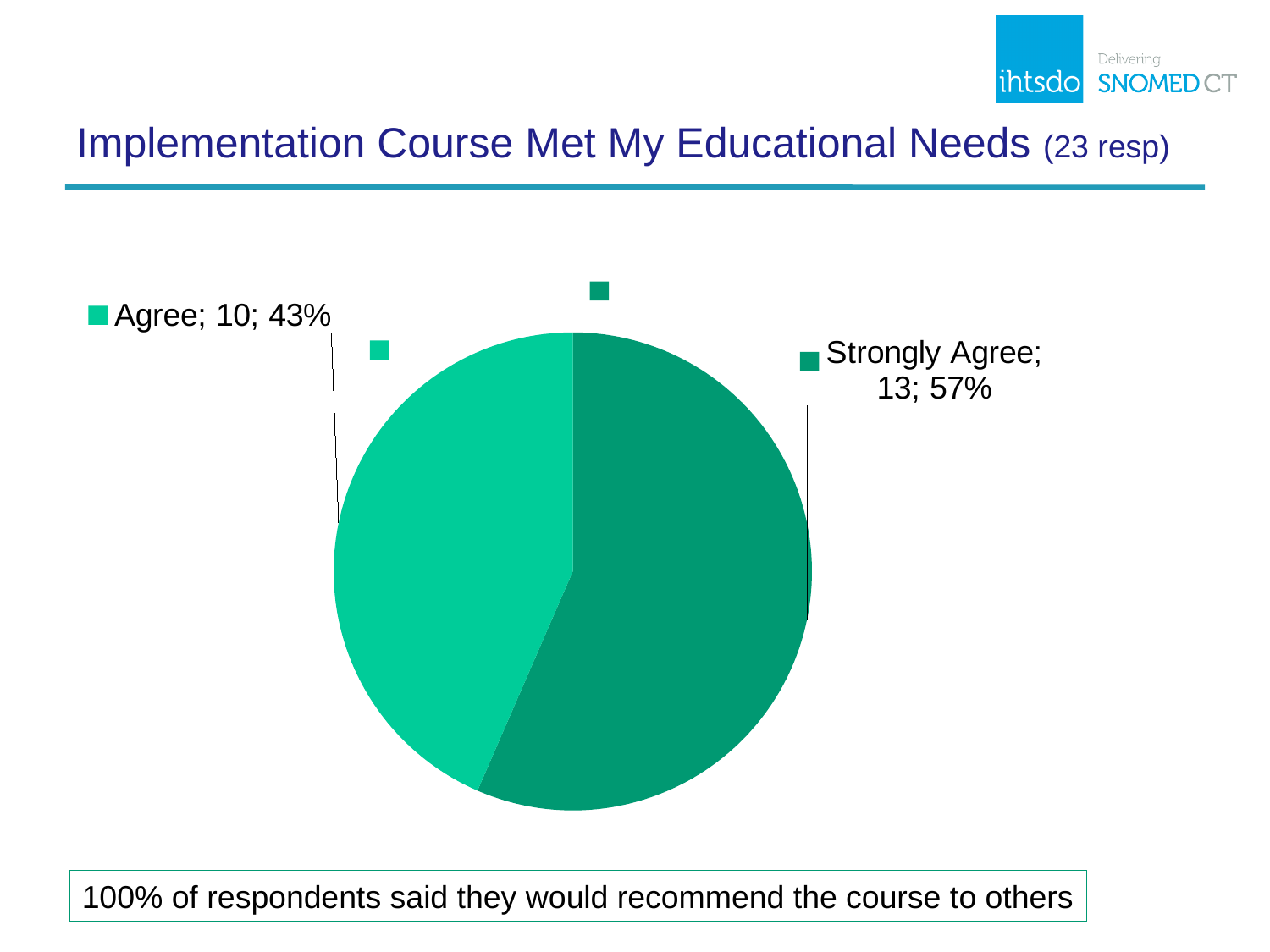
What percentage of the pie does the "Agree" slice represent? 43% How many categories are shown in the pie chart? 2 What is the title of the chart on the slide? Implementation Course Met My Educational Needs (23 resp) How many respondents chose "Agree"? 10 How many respondents chose "Strongly Agree"? 13 What percentage of the pie does the "Strongly Agree" slice represent? 57% Which is larger: the number of "Agree" responses or the number of "Strongly Agree" responses? Strongly Agree What kind of chart is shown on the slide? pie chart Which category has the largest slice of the pie? Strongly Agree What is the total number of respondents across both slices of the pie? 23 How many more respondents chose "Strongly Agree" than "Agree"? 3 Which category has the smallest slice of the pie? Agree